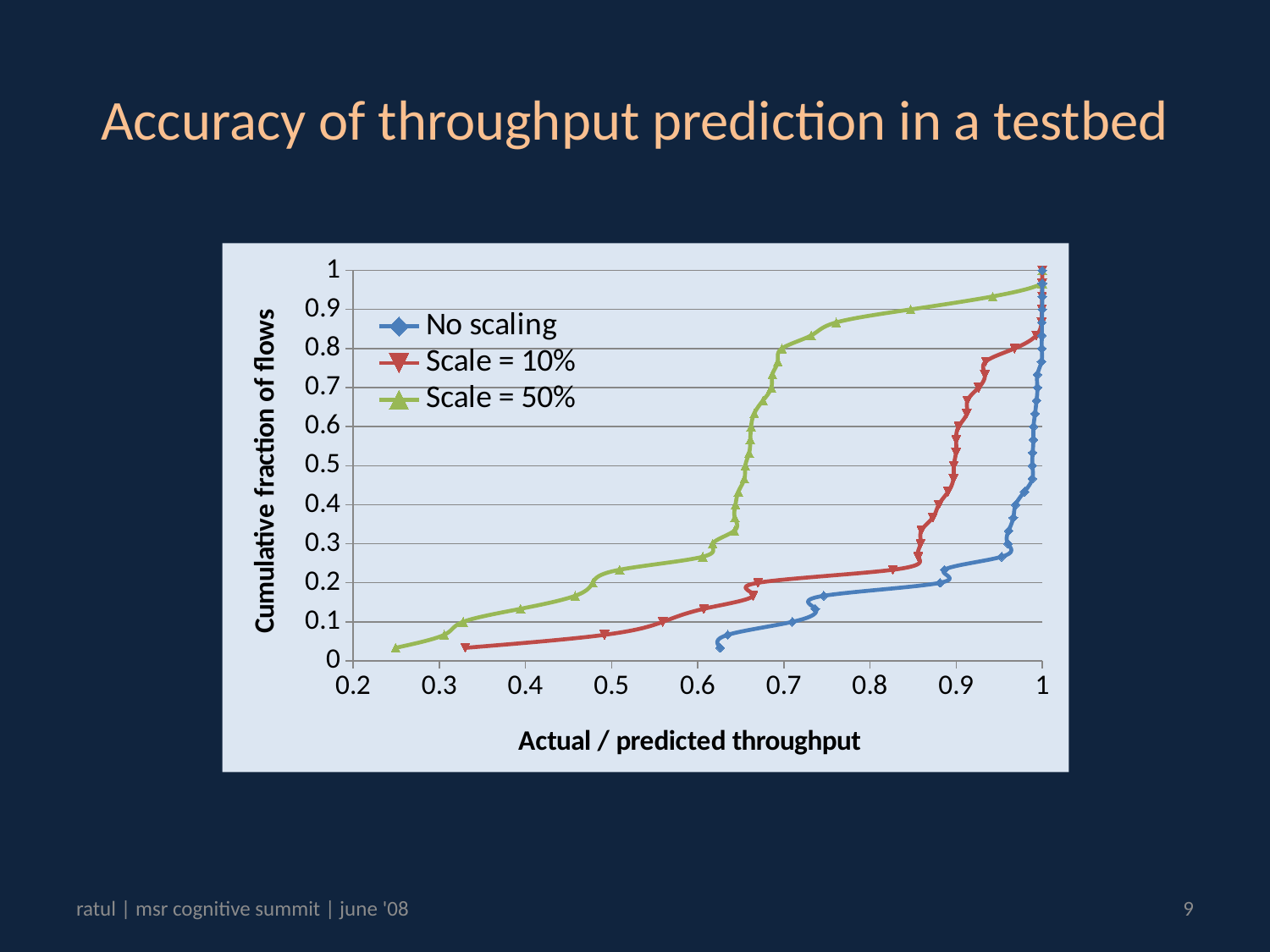
What are the three series named in the legend? No scaling, Scale = 10%, Scale = 50% Do the curves rise or fall as the actual / predicted throughput increases along the x axis? Rise At a cumulative fraction of flows of 0.5, is the actual / predicted throughput for No scaling greater or less than 0.9? greater What kind of chart is shown on the slide? Line chart Is the smallest actual / predicted throughput plotted for the No scaling series greater or less than 0.6? greater What is the label of the x axis? Actual / predicted throughput Which series reaches a cumulative fraction of 0.5 at the lowest actual / predicted throughput? Scale = 50% How many series does the legend list? 3 Is the smallest actual / predicted throughput plotted for the Scale = 50% series greater or less than 0.3? less At a cumulative fraction of flows of 0.5, which series has the larger actual / predicted throughput, No scaling or Scale = 50%? No scaling